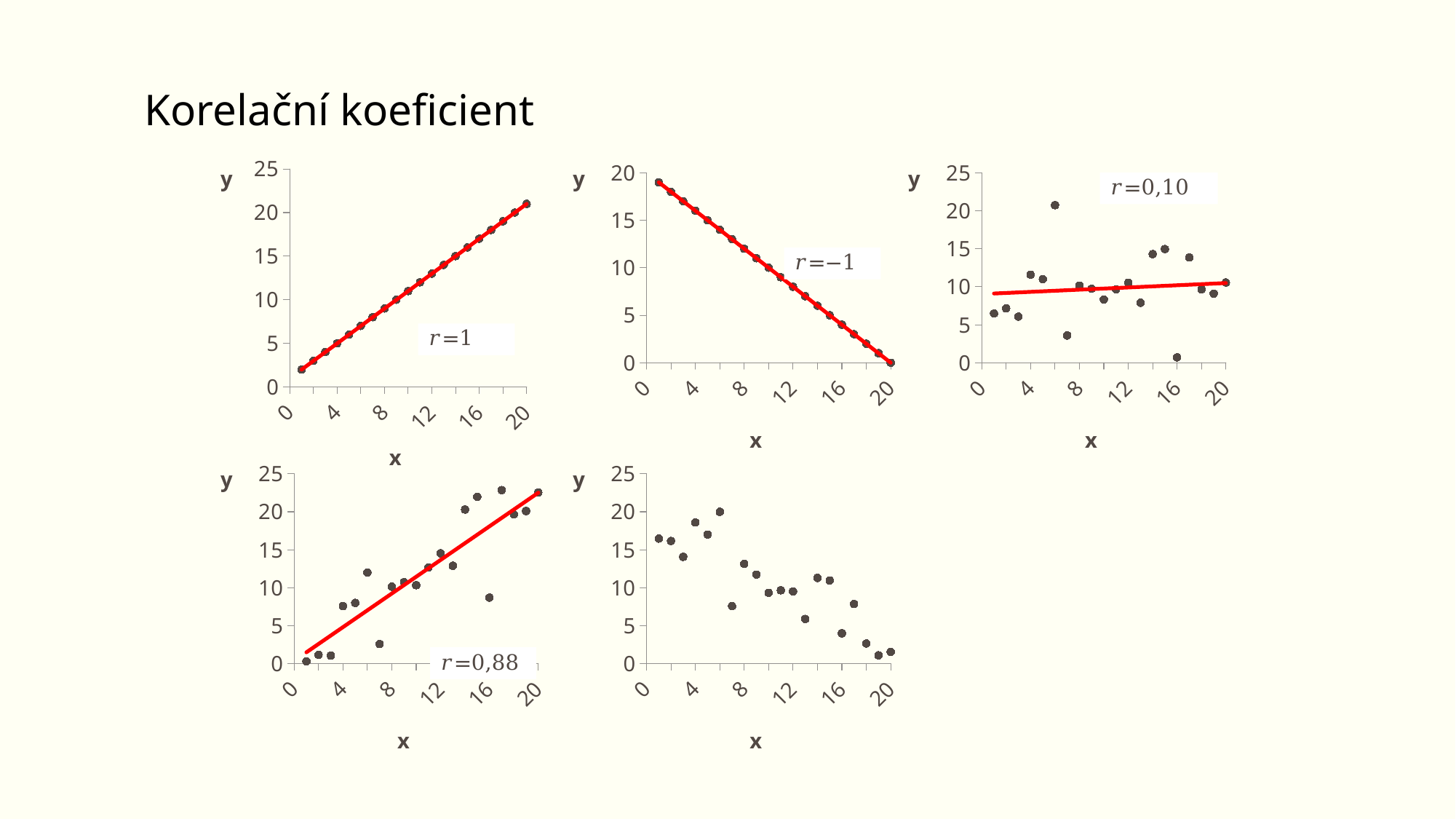
In the bottom-left chart labelled r=0,88, do the y values generally rise or fall as x increases? rise What kind of chart is the top-left chart labelled r=1? scatter chart In the top-left chart labelled r=1, do the y values rise or fall as x increases? rise In the bottom-left chart labelled r=0,88, is the y value at x=7 greater or less than 5? less In the top-right chart labelled r=0,10, is the y value at x=16 greater or less than 5? less In the top-middle chart labelled r=−1, what is the y value at x=20? 0 How many charts are shown on the slide? 5 In the top-middle chart labelled r=−1, do the y values rise or fall as x increases? fall What correlation coefficient is printed on the top-right chart? r=0,10 What is the title of the slide? Korelační koeficient In the bottom-middle chart (the one without an r label), is the y value at x=6 greater or less than 15? greater